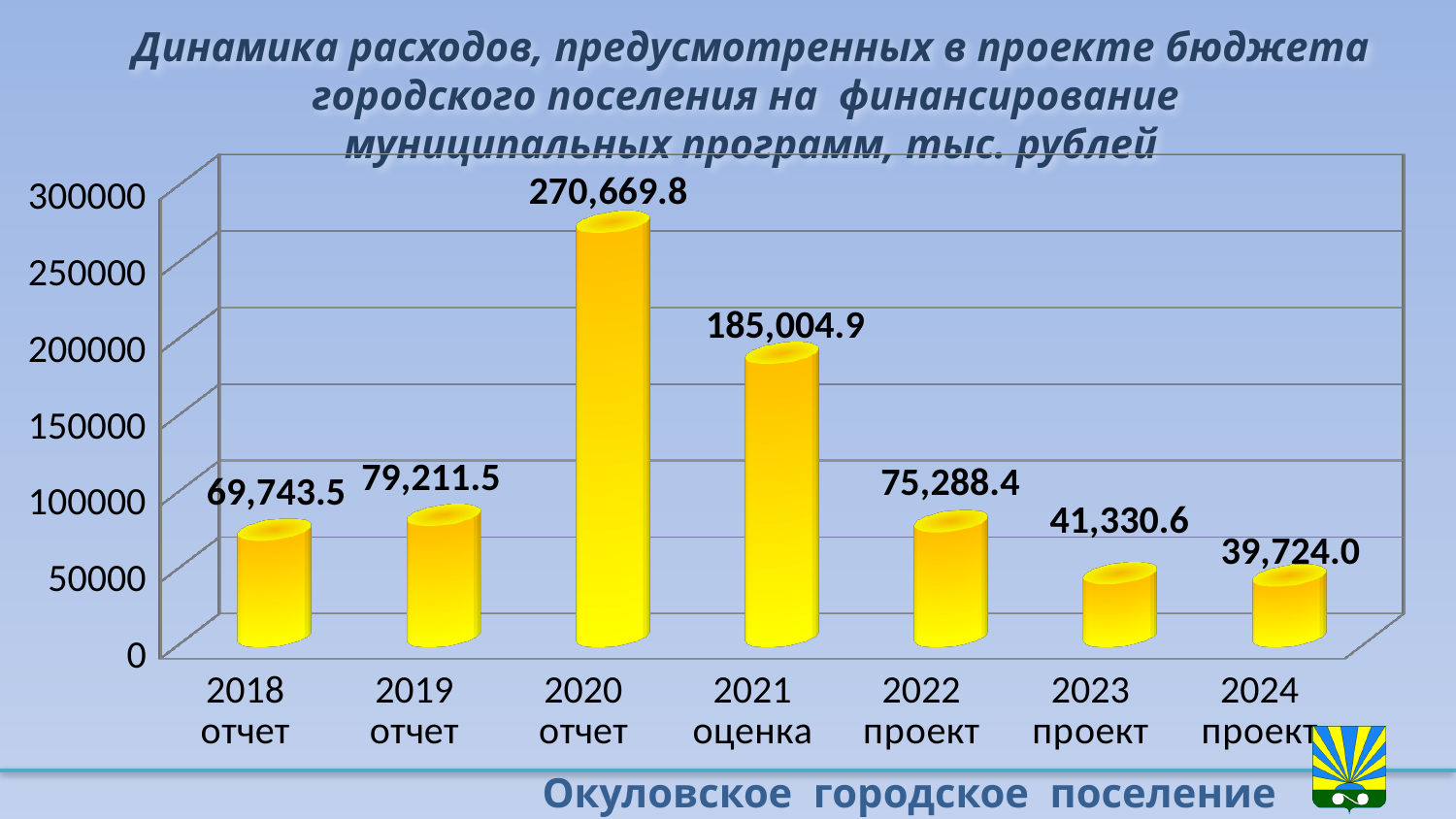
How many categories are shown on the x axis? 7 Which category has the lowest value? 2024 проект What is the difference between the values for 2020 отчет and 2021 оценка? 85,664.9 What kind of chart is shown on the slide? bar chart Do the values rise or fall from 2021 оценка to 2024 проект? fall What is the value for 2020 отчет? 270,669.8 What is the difference between the values for 2019 отчет and 2018 отчет? 9,468.0 Is the value for 2021 оценка greater or less than 150000? greater Which category has the highest value? 2020 отчет What is the value for 2023 проект? 41,330.6 Which is larger, the value for 2022 проект or the value for 2019 отчет? 2019 отчет What is the value for 2018 отчет? 69,743.5